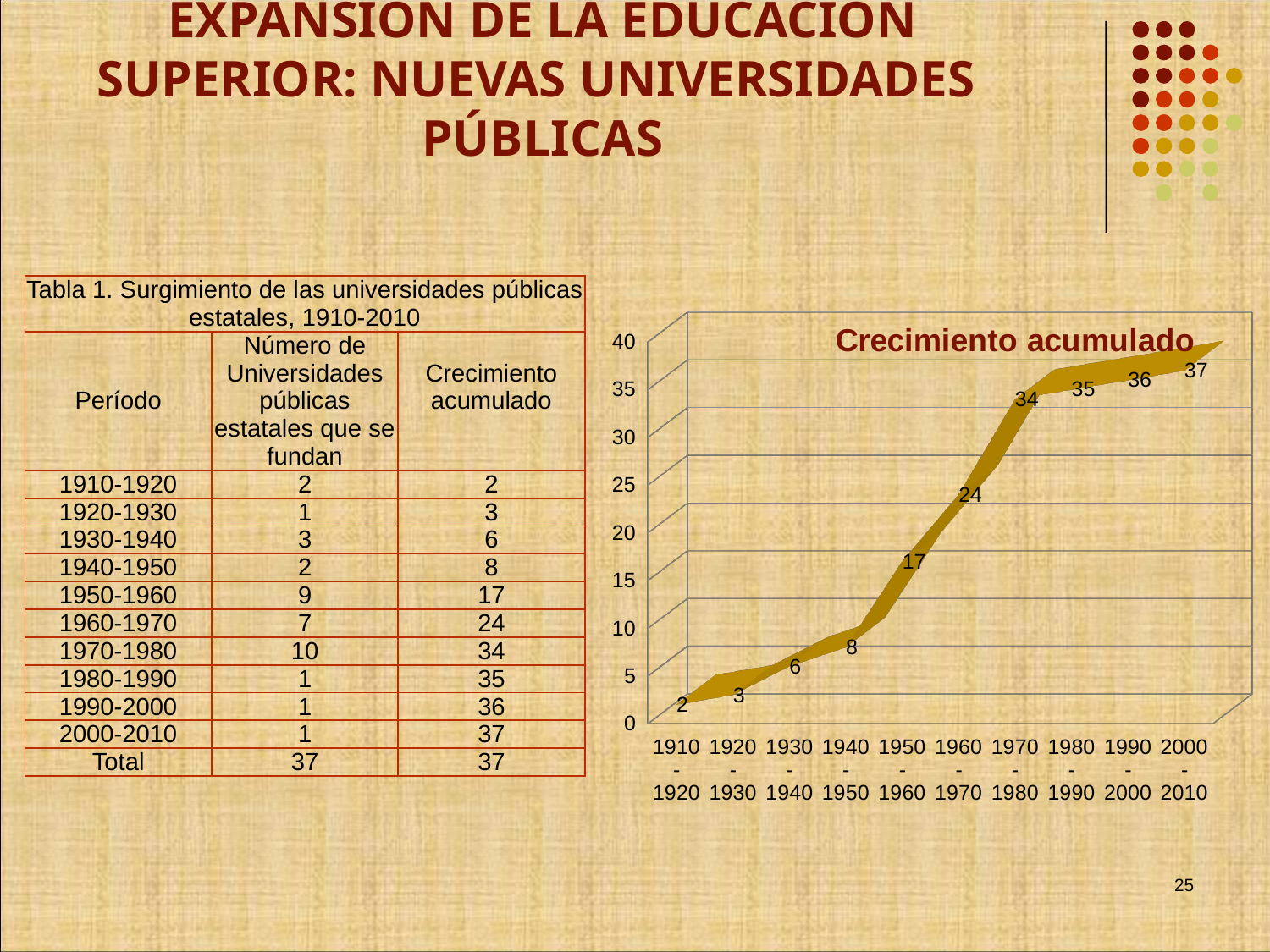
Which is larger, the value for 1940-1950 or the value for 1950-1960? 1950-1960 Is the value for 1960-1970 greater or less than 20? greater Do the values rise or fall along the x axis of the chart? rise What is the value for the period 1950-1960 in the chart? 17 What is the value for the period 1910-1920 in the chart? 2 Which period has the highest value in the chart? 2000-2010 What is the value for the period 1970-1980 in the chart? 34 What is the difference between the values for 1970-1980 and 1960-1970? 10 What is the title of the chart? Crecimiento acumulado How many periods are plotted on the x axis of the chart? 10 What type of chart is shown on the slide? line chart Which period has the lowest value in the chart? 1910-1920